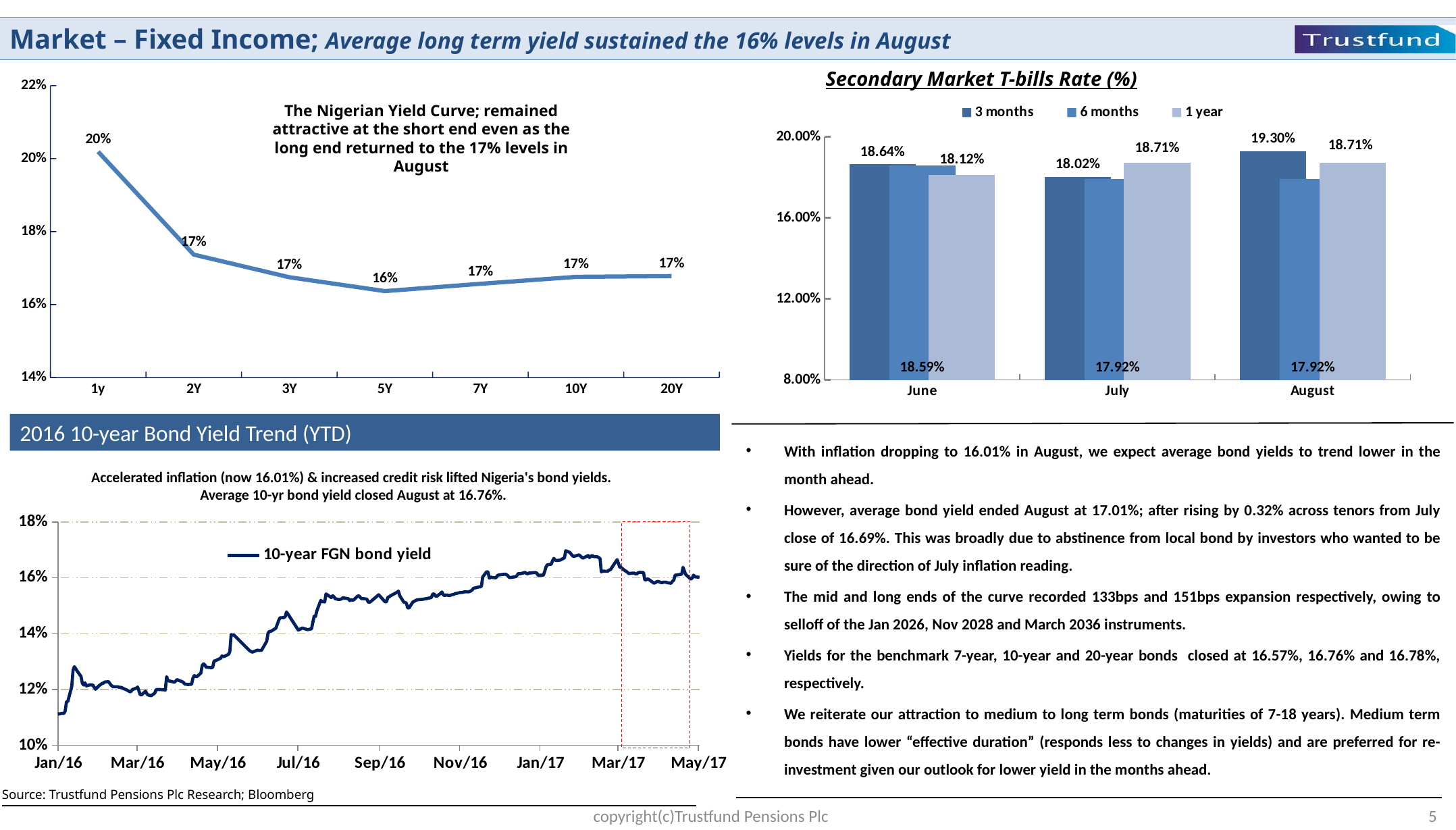
In the Nigerian Yield Curve chart, how many tenors are plotted on the x axis? 7 In the Secondary Market T-bills Rate chart, what is the 3 months rate for August? 19.30% What kind of chart is the Secondary Market T-bills Rate chart? Bar chart In the Secondary Market T-bills Rate chart, what is the difference between the 3 months rate and the 6 months rate in August? 1.38% In the Nigerian Yield Curve chart, what is the yield for the 1y tenor? 20% In the 2016 10-year Bond Yield Trend chart, is the 10-year FGN bond yield at Jan/16 greater or less than 12%? less In the Secondary Market T-bills Rate chart, what is the 1 year rate for June? 18.12% In the Nigerian Yield Curve chart, what is the difference between the 1y yield and the 5Y yield? 4% In the Secondary Market T-bills Rate chart, how many series does the legend list? 3 In the Nigerian Yield Curve chart, which tenor has the lowest yield? 5Y In the 2016 10-year Bond Yield Trend chart, does the 10-year FGN bond yield generally rise or fall from Jan/16 to Jan/17? rise In the Secondary Market T-bills Rate chart, which is larger for July: the 3 months rate or the 1 year rate? 1 year rate